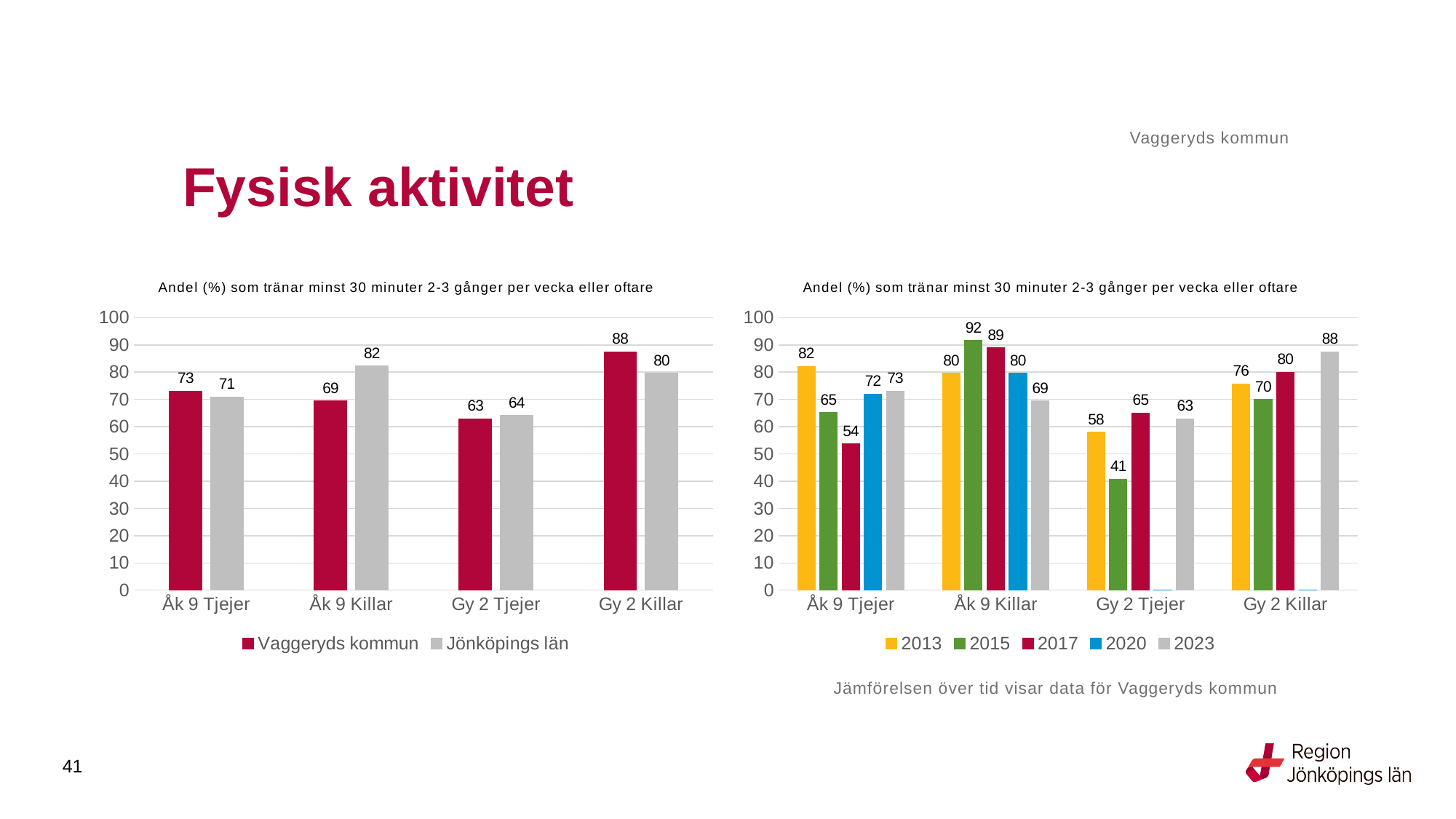
In the right chart, which year has the lowest value for Gy 2 Tjejer? 2015 What kind of chart is the left chart? Bar chart How many categories are shown on the x axis of the right chart? 4 In the left chart, what is the value for Vaggeryds kommun for Gy 2 Killar? 88 In the right chart, what is the value for 2015 for Åk 9 Killar? 92 In the left chart, which is larger for Åk 9 Tjejer: Vaggeryds kommun or Jönköpings län? Vaggeryds kommun In the right chart, what is the value for 2017 for Åk 9 Tjejer? 54 In the left chart, what is the value for Jönköpings län for Åk 9 Killar? 82 In the left chart, which category has the lowest value for Vaggeryds kommun? Gy 2 Tjejer How many series does the legend of the right chart list? 5 In the right chart, what is the difference between 2023 and 2013 for Gy 2 Killar? 12 In the left chart, what is the difference between Jönköpings län and Vaggeryds kommun for Åk 9 Killar? 13